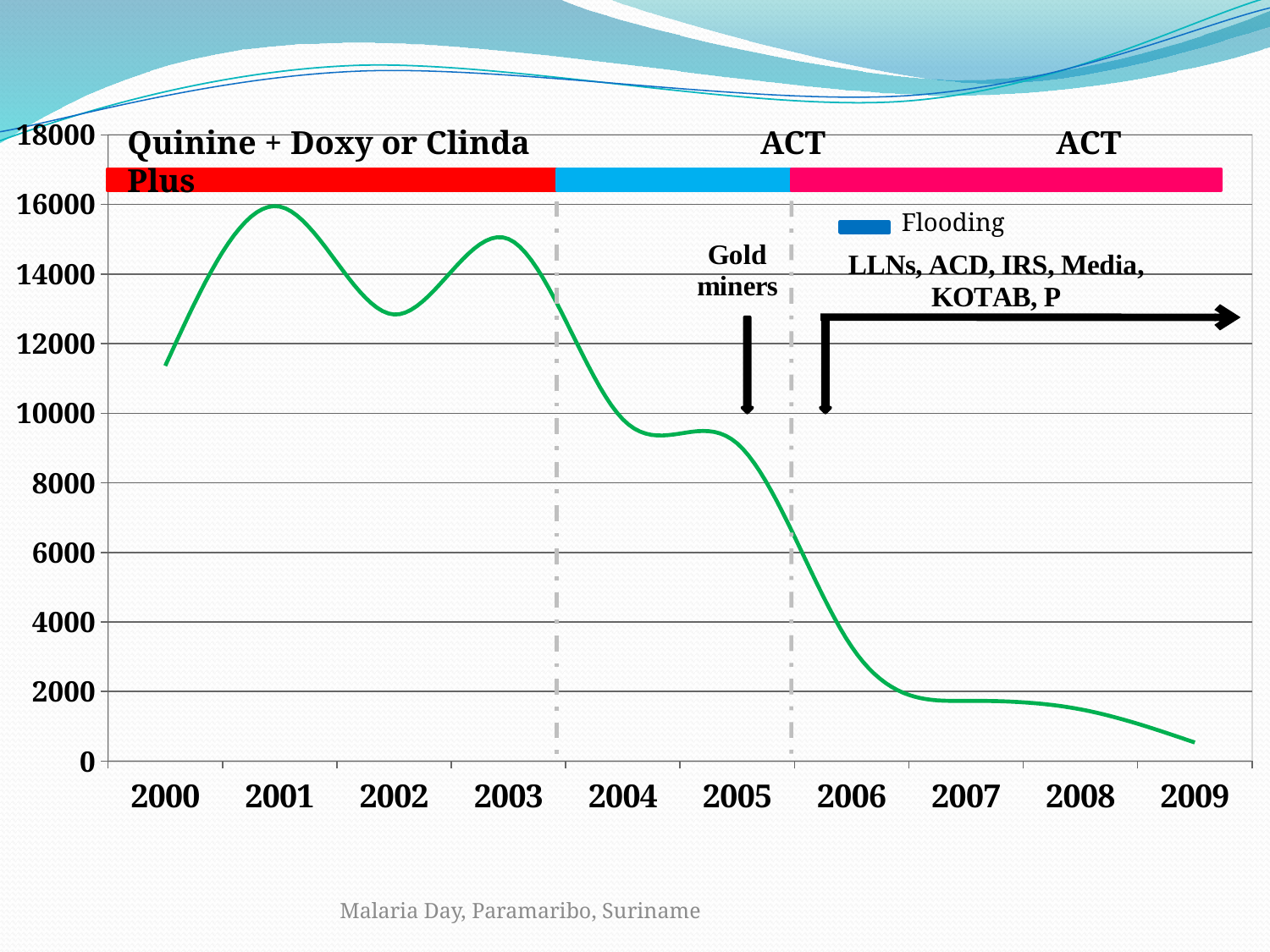
What kind of chart is shown on the slide? line chart How many years are plotted along the x axis? 10 Which year has the lowest value on the line? 2009 Is the value for 2009 greater or less than 2000? less Which year has the larger value, 2005 or 2006? 2005 Do the values generally rise or fall from 2003 to 2009? fall What event does the blue legend entry above the chart refer to? Flooding Is the value for 2004 greater or less than 10000? less Is the value for 2006 greater or less than 4000? less Which year has the highest value on the line? 2001